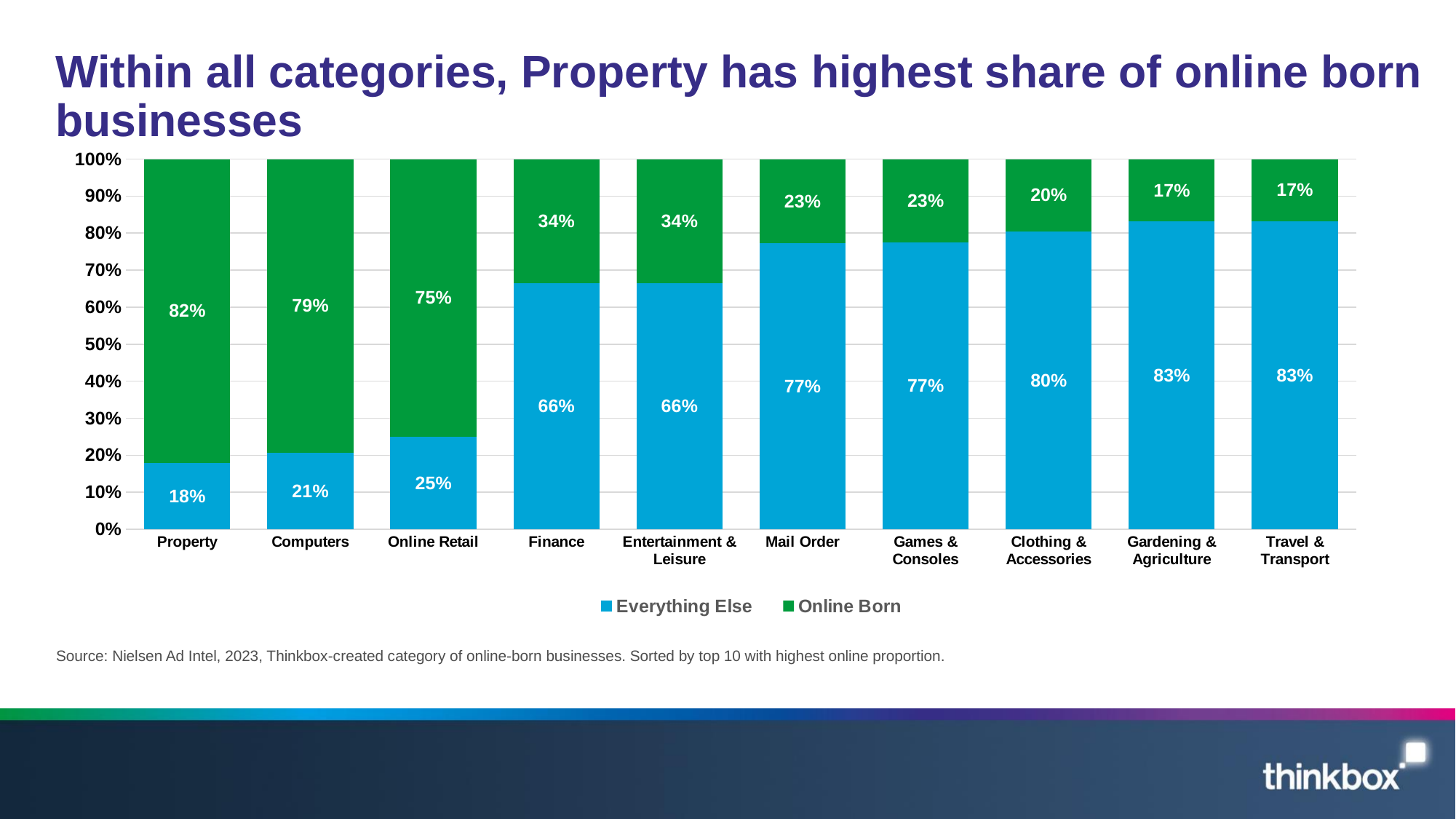
What is the difference between the Online Born share for Computers and for Finance? 45% What kind of chart is shown on the slide? Stacked bar chart How many series does the legend list? 2 Which is larger: the Online Born share for Online Retail or for Mail Order? Online Retail How many categories are shown on the x axis? 10 Does the Online Born share rise or fall moving from left to right along the x axis? Fall Which category has the highest Online Born share? Property Which category has the lowest Everything Else share? Property What is the Online Born share for Property? 82% What is the Online Born share for Clothing & Accessories? 20% What is the Everything Else share for Mail Order? 77% Which colour represents the Online Born series? Green